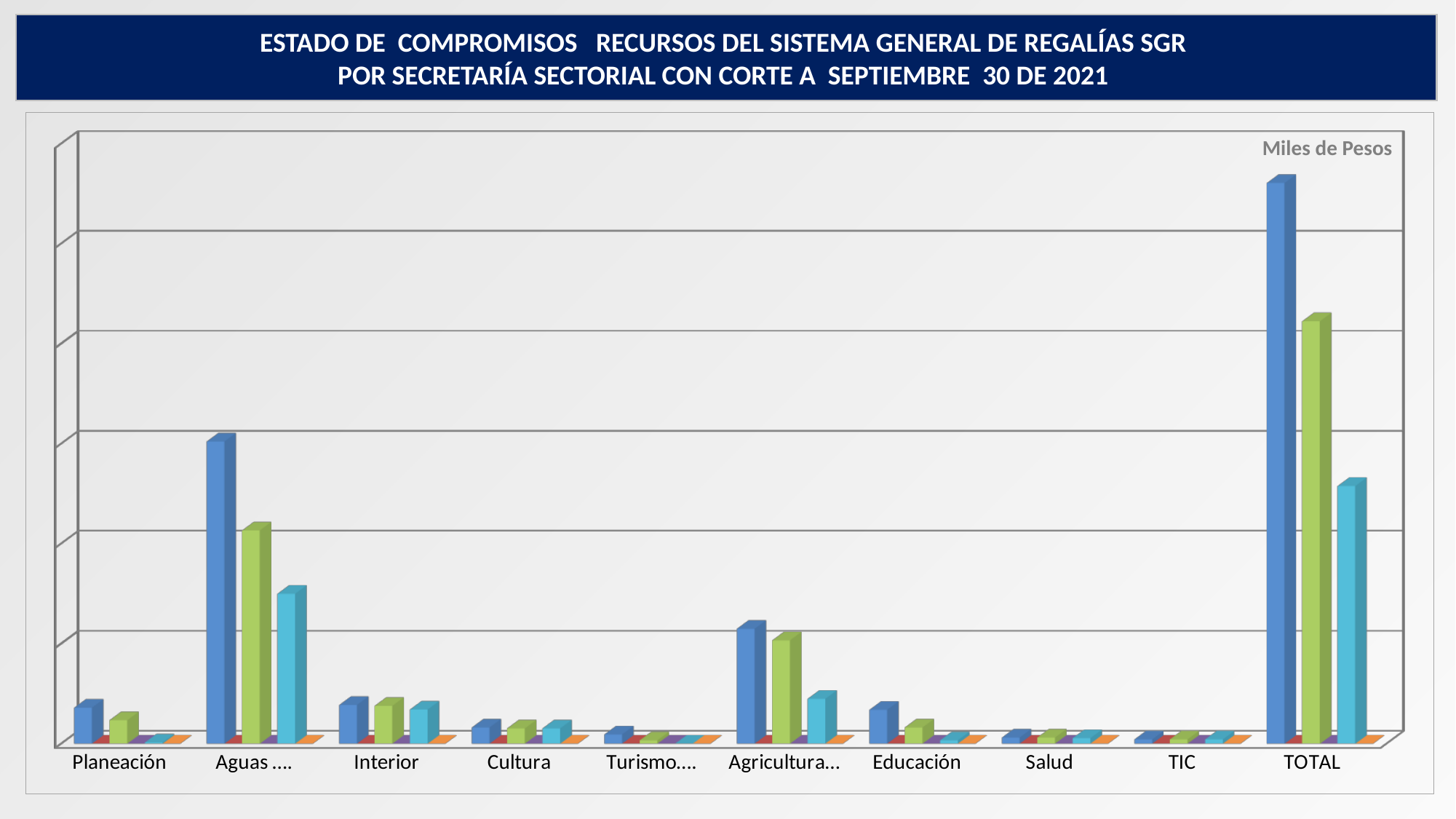
Which category has the tallest bar in the chart? TOTAL How many categories are shown along the x axis of the chart? 10 Which is larger, the blue bar for Aguas .... or the blue bar for Agricultura...? Aguas .... What cut-off date is stated in the chart title? Septiembre 30 de 2021 Which is larger, the green bar for Interior or the green bar for Cultura? Interior Within the TOTAL category, which bar is taller, the blue one or the green one? Blue Excluding TOTAL, which secretaría has the tallest blue bar? Aguas .... What kind of chart is shown on the slide? Bar chart What unit label is shown in the top right corner of the chart area? Miles de Pesos